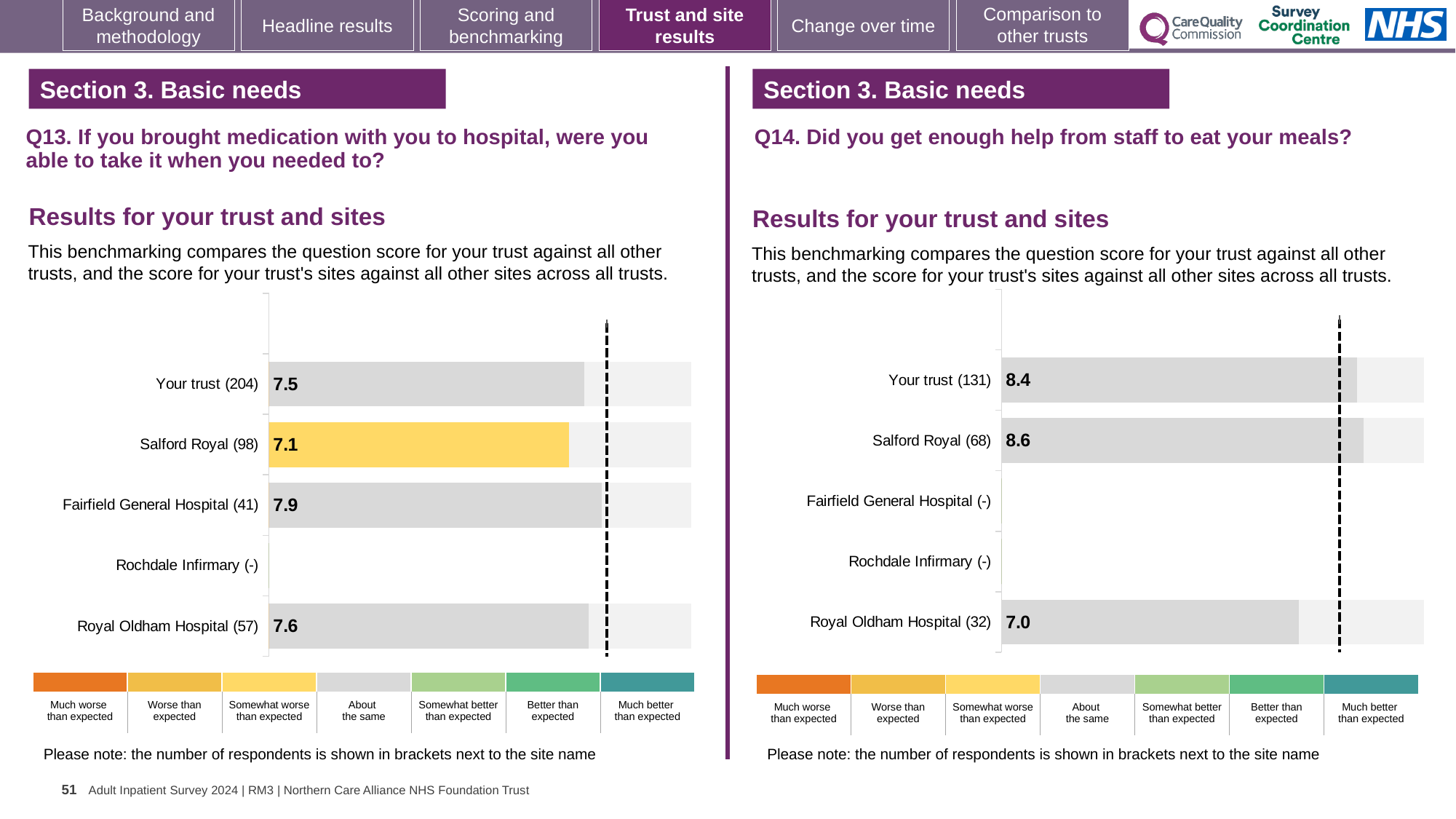
On the Q13 chart (left), which is higher: Royal Oldham Hospital or Your trust? Royal Oldham Hospital On the Q14 chart (right), what is the difference between the scores for Salford Royal and Royal Oldham Hospital? 1.6 On the Q14 chart (right), how many respondents are shown for Your trust? 131 On the Q14 chart (right), which site has the highest score? Salford Royal On the Q13 chart (left), what is the difference between the scores for Fairfield General Hospital and Salford Royal? 0.8 On the Q13 chart (left), what is the score for Salford Royal? 7.1 On the Q13 chart (left), which site has the highest score? Fairfield General Hospital On the Q13 chart (left), which site with a score shown has the lowest score? Salford Royal What kind of chart is used on the Q13 chart (left)? Bar chart How many site/trust categories are listed on the Q14 chart (right)? 5 On the Q13 chart (left), what is the score for Your trust? 7.5 On the Q14 chart (right), what is the score for Royal Oldham Hospital? 7.0